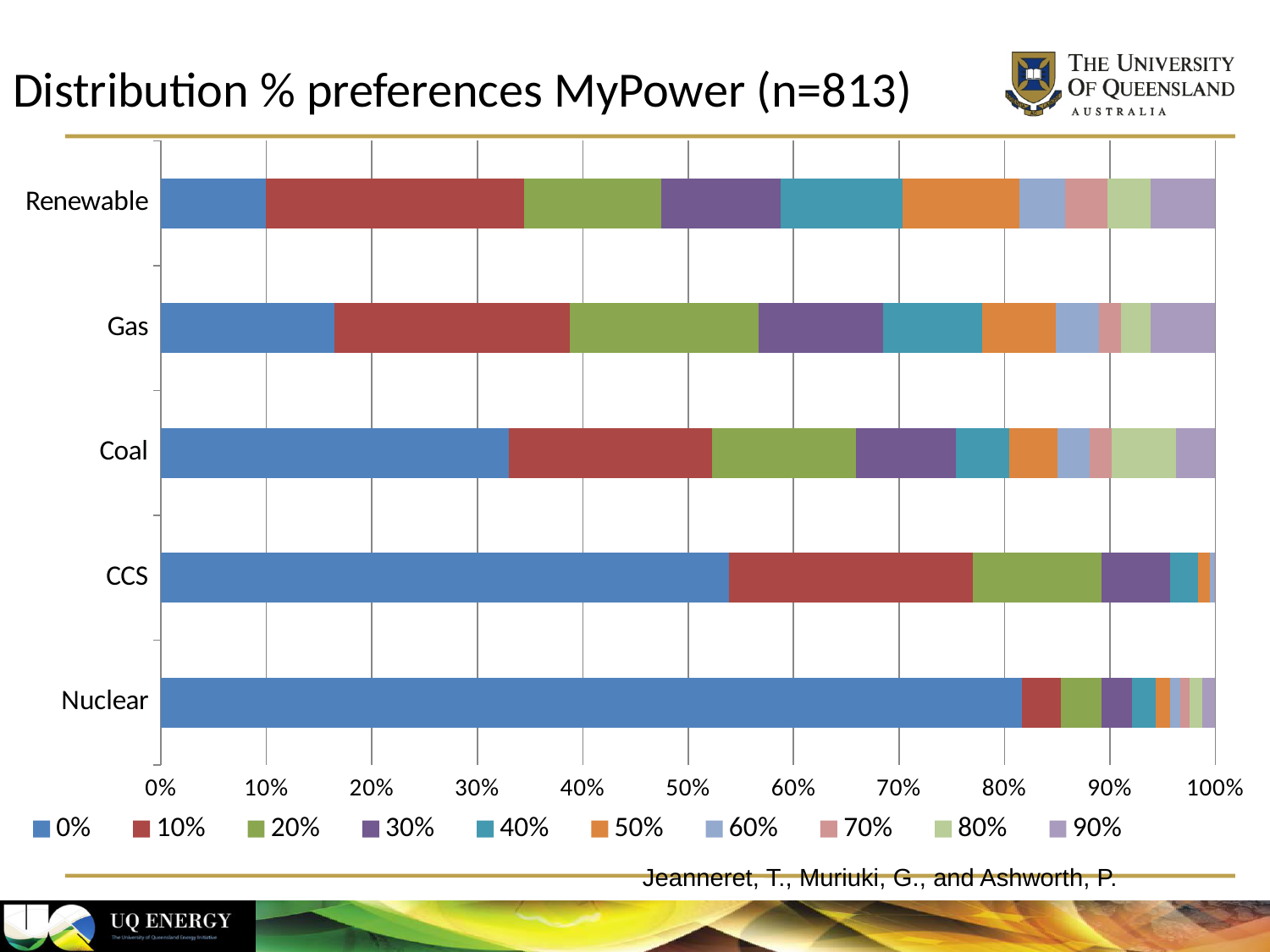
What is the first entry in the legend? 0% How many series does the legend list? 10 What is the total of the stacked bar for Nuclear? 100% What is the title of the chart? Distribution % preferences MyPower (n=813) Is the 0% (blue) segment for Gas greater or less than 20%? less Which category has the largest 0% (blue) segment? Nuclear How many categories are plotted on the vertical axis? 5 Is the 0% (blue) segment for Nuclear greater or less than 70%? greater Which has the larger 0% (blue) segment, CCS or Coal? CCS What kind of chart is shown on the slide? stacked bar chart Is the 0% (blue) segment for CCS greater or less than 50%? greater Which category has the smallest 0% (blue) segment? Renewable